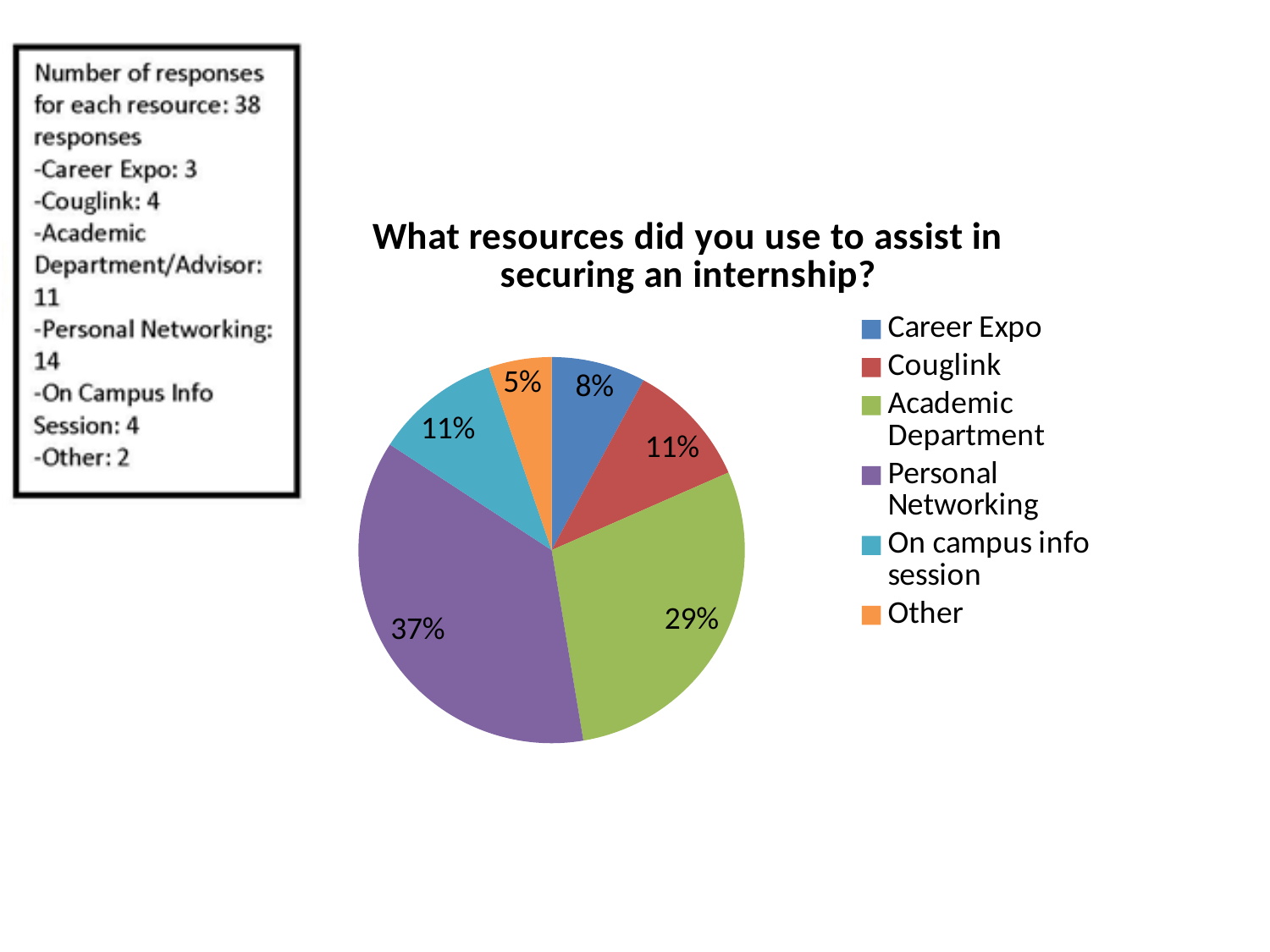
What type of chart is shown on the slide? Pie chart What is the value shown for Couglink? 11% How many categories does the pie chart show? 6 Which is larger, the slice for Career Expo or the slice for On campus info session? On campus info session What is the difference in percentage points between Personal Networking and Academic Department? 8 What share of the pie does Academic Department represent? 29% What is the value shown for Other? 5% Which category has the smallest slice of the pie? Other What is the value shown for Career Expo? 8% What share of the pie does Personal Networking represent? 37% What is the title of the chart? What resources did you use to assist in securing an internship? Which category has the largest slice of the pie? Personal Networking